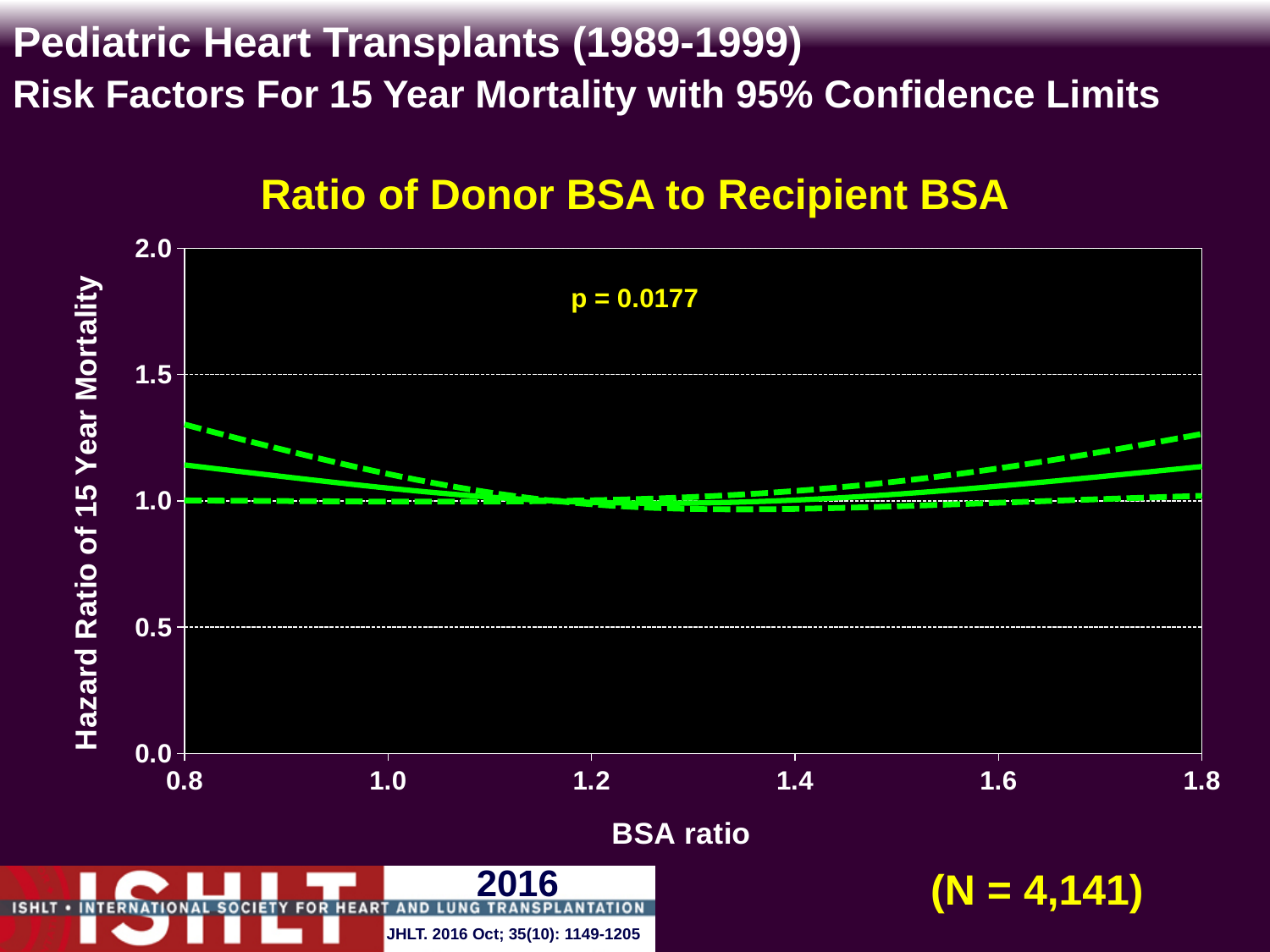
Is the hazard ratio (solid line) at a BSA ratio of 0.8 greater or less than 1.0? greater Does the hazard ratio (solid line) rise or fall as the BSA ratio increases from 0.8 to 1.2? fall Does the hazard ratio (solid line) rise or fall as the BSA ratio increases from 1.2 to 1.8? rise What is the label of the x-axis? BSA ratio What kind of chart is shown on the slide? Line chart What p-value is printed on the chart? p = 0.0177 Is the hazard ratio (solid line) at a BSA ratio of 0.8 greater or less than 1.5? less How many lines are plotted on the chart? 3 What is the title of the chart? Ratio of Donor BSA to Recipient BSA Is the hazard ratio (solid line) at a BSA ratio of 1.8 greater or less than 1.0? greater What is the label of the y-axis? Hazard Ratio of 15 Year Mortality What sample size (N) is shown on the slide? N = 4,141